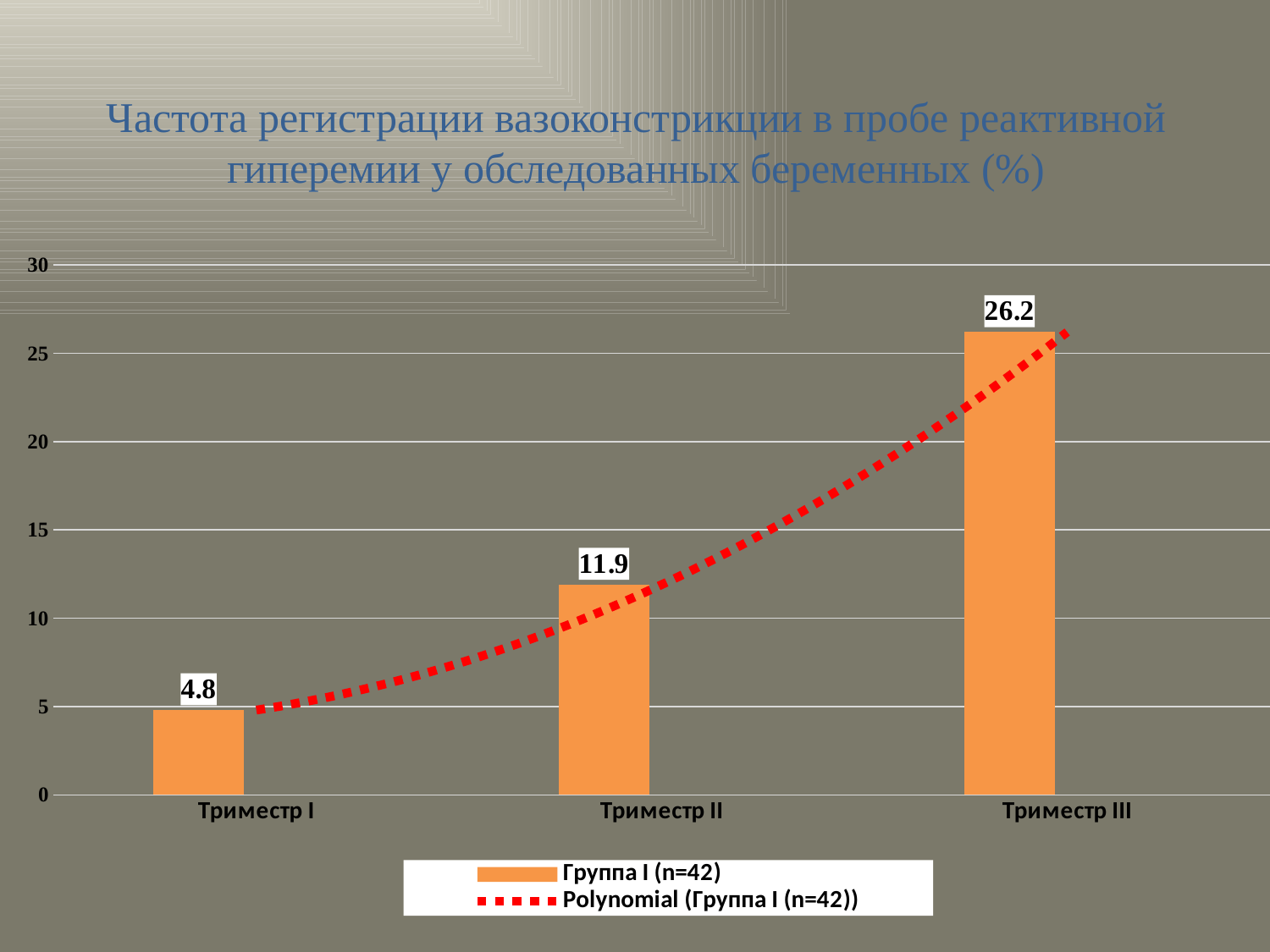
Do the values rise or fall from Триместр I to Триместр III? Rise Which is larger, the value for Триместр II or Триместр III? Триместр III What is the difference between the values for Триместр II and Триместр I? 7.1 What is the value for Триместр II? 11.9 How many entries does the legend list? 2 What is the value for Триместр III? 26.2 What is the difference between the values for Триместр III and Триместр I? 21.4 Which trimester has the lowest value? Триместр I What is the value for Триместр I? 4.8 Which trimester has the highest value? Триместр III How many categories are shown on the x axis? 3 What kind of chart is shown on the slide? Bar chart